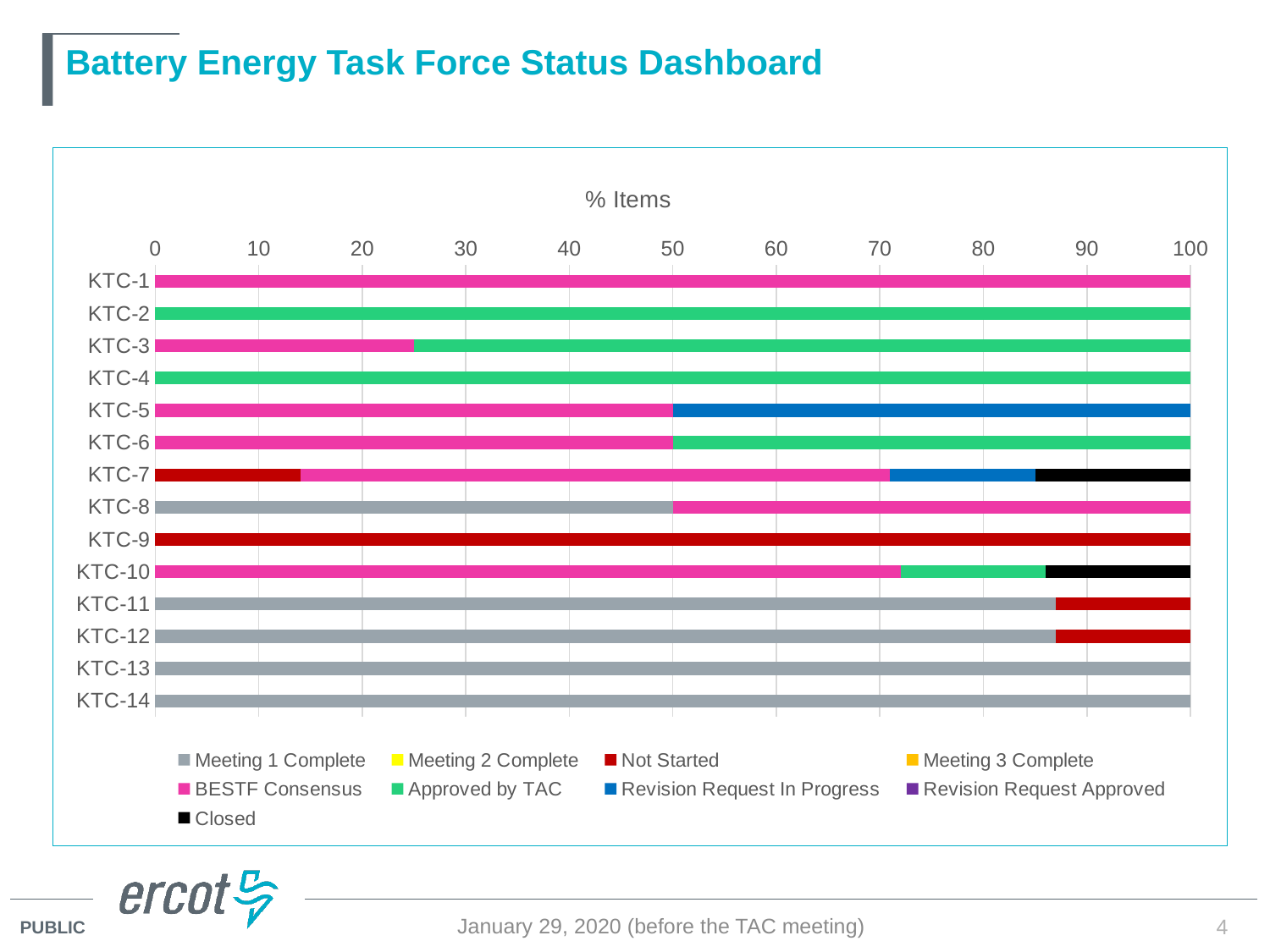
What kind of chart is shown on the slide? bar chart Is the Not Started value for KTC-7 greater or less than 20? less Which colour represents the 'Closed' series in the legend? black Is the Meeting 1 Complete value for KTC-11 greater or less than 80? greater Is the Revision Request In Progress value for KTC-5 greater or less than 40? greater How many KTC categories are plotted on the chart? 14 Which has the larger BESTF Consensus segment, KTC-7 or KTC-10? KTC-10 How many series does the chart legend list? 9 What is the title of the chart? % Items Which single status makes up the entire bar for KTC-9? Not Started What is the total of the stacked bar for KTC-1? 100